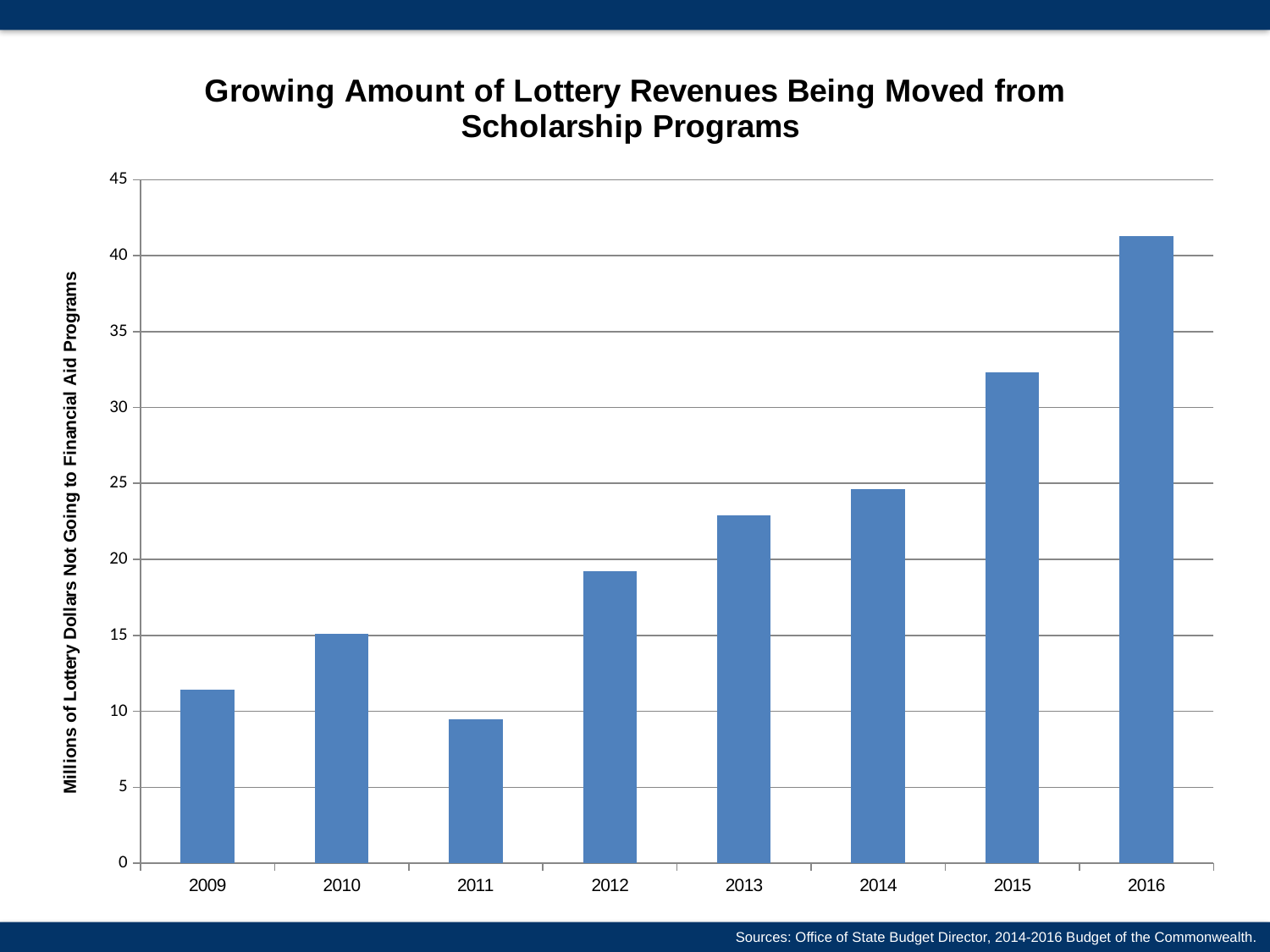
What kind of chart is shown on the slide? bar chart What is the label on the vertical axis of the chart? Millions of Lottery Dollars Not Going to Financial Aid Programs Which is larger, the value for 2014 or the value for 2015? 2015 Which year has the highest value in the chart? 2016 How many years are shown on the x axis of the chart? 8 Is the value for 2016 greater or less than 40? greater Which year has the lowest value in the chart? 2011 Do the values generally rise or fall from 2011 to 2016? rise Is the value for 2015 greater or less than 30? greater Is the value for 2011 greater or less than 10? less